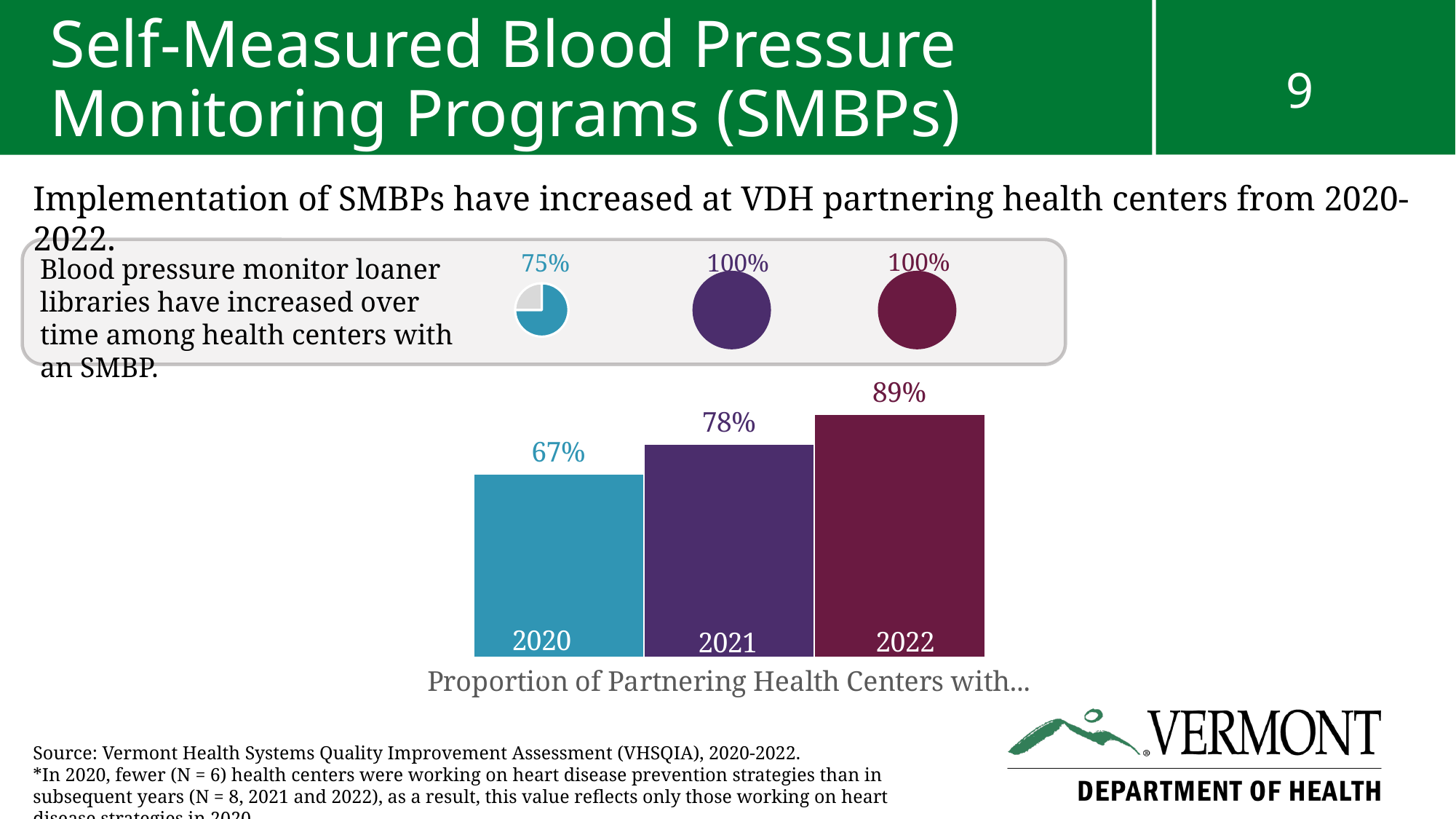
In the bar chart, what is the value for 2021? 78% How many bars are in the bar chart? 3 In the small pie charts in the grey box, what is the value shown for the first (blue) pie? 75% In the bar chart, what is the value for 2020? 67% In the bar chart, what is the difference between the 2021 and 2020 values? 11% In the bar chart, what is the value for 2022? 89% In the bar chart, what is the difference between the 2022 and 2020 values? 22% In the bar chart, which year has the lowest value? 2020 In the bar chart, which year has the highest value? 2022 What kind of chart shows the values for 2020, 2021 and 2022? Bar chart In the bar chart, do the values rise or fall from 2020 to 2022? Rise In the bar chart, which is larger, the value for 2021 or the value for 2022? 2022